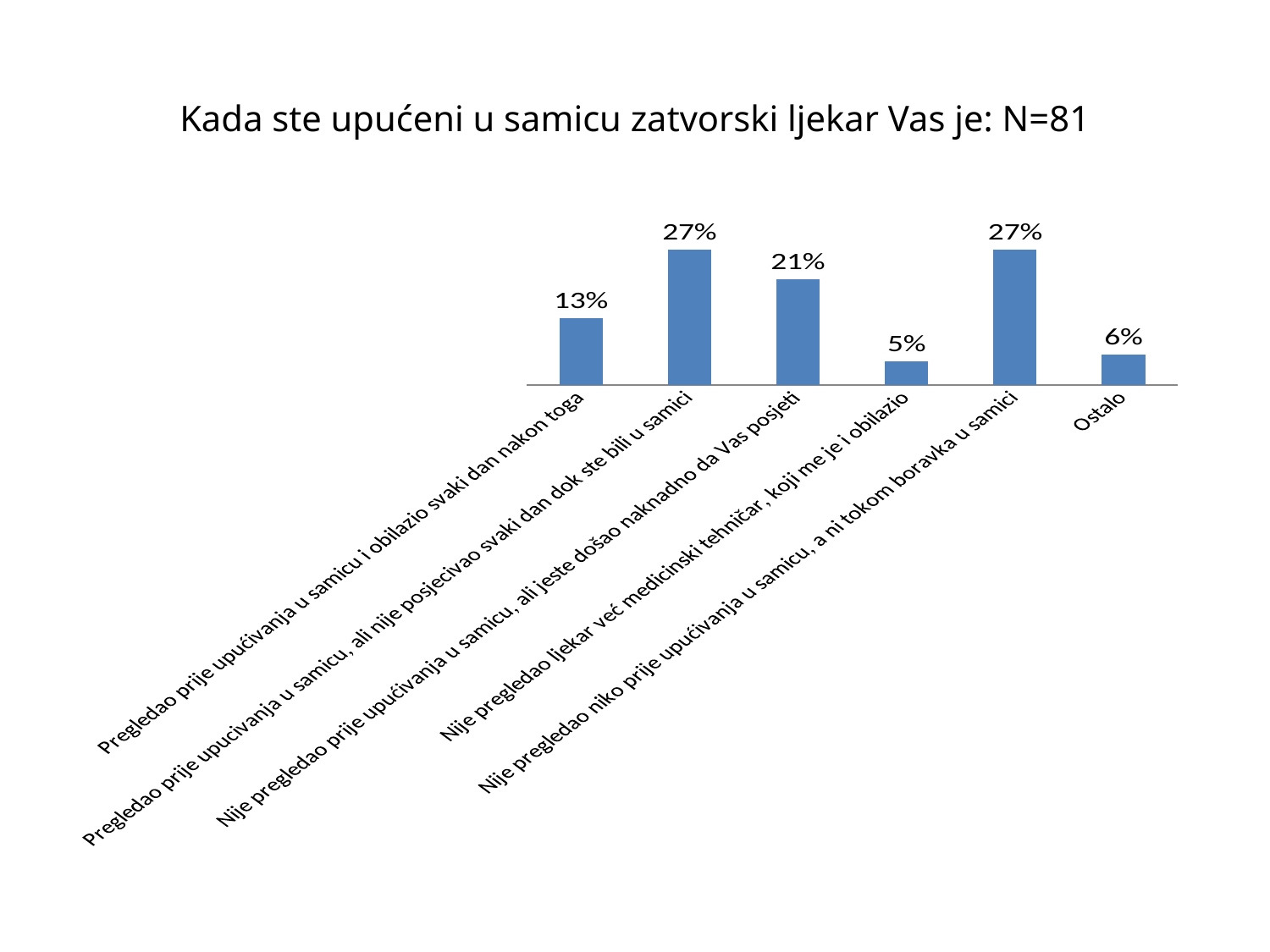
How many categories are plotted in the chart? 6 Which category has the lowest value? Nije pregledao ljekar već medicinski tehničar, koji me je i obilazio What is the value for "Pregledao prije upućivanja u samicu i obilazio svaki dan nakon toga"? 13% What is the title of the chart? Kada ste upućeni u samicu zatvorski ljekar Vas je: N=81 What is the value for "Ostalo"? 6% What kind of chart is shown on the slide? bar chart What is the difference between the value for "Nije pregledao niko prije upućivanja u samicu, a ni tokom boravka u samici" and the value for "Ostalo"? 21% What is the value for "Nije pregledao prije upućivanja u samicu, ali jeste došao naknadno da Vas posjeti"? 21% Which is larger: the value for "Nije pregledao prije upućivanja u samicu, ali jeste došao naknadno da Vas posjeti" or the value for "Pregledao prije upućivanja u samicu i obilazio svaki dan nakon toga"? Nije pregledao prije upućivanja u samicu, ali jeste došao naknadno da Vas posjeti What is the highest value shown in the chart? 27% What is the difference between the value for "Pregledao prije upućivanja u samicu i obilazio svaki dan nakon toga" and the value for "Nije pregledao ljekar već medicinski tehničar, koji me je i obilazio"? 8% What is the value for "Pregledao prije upućivanja u samicu, ali nije posjećivao svaki dan dok ste bili u samici"? 27%